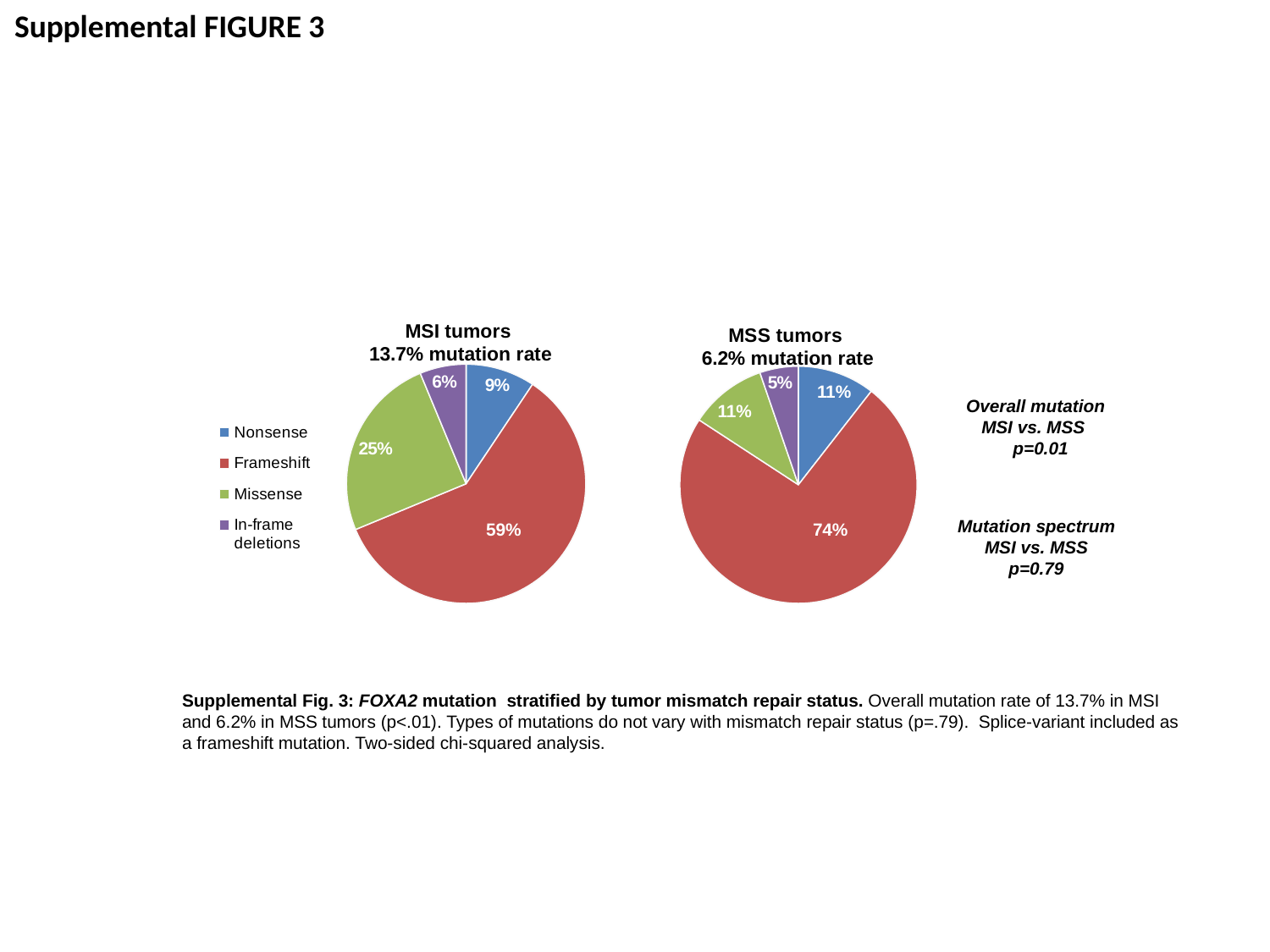
In the MSI tumors pie chart, what share is Frameshift? 59% In the MSS tumors pie chart, what share is Frameshift? 74% In the MSS tumors pie chart, which mutation type has the largest slice? Frameshift In the MSI tumors pie chart, what share is Missense? 25% What is the difference between the Frameshift share in MSS tumors and the Frameshift share in MSI tumors? 15% How many mutation types does the legend list? 4 What mutation rate is stated in the title of the MSS tumors chart? 6.2% mutation rate Is the Missense share larger in the MSI tumors chart or the MSS tumors chart? MSI tumors What kind of chart is used for the MSI tumors data? Pie chart In the MSI tumors pie chart, which mutation type has the smallest slice? In-frame deletions